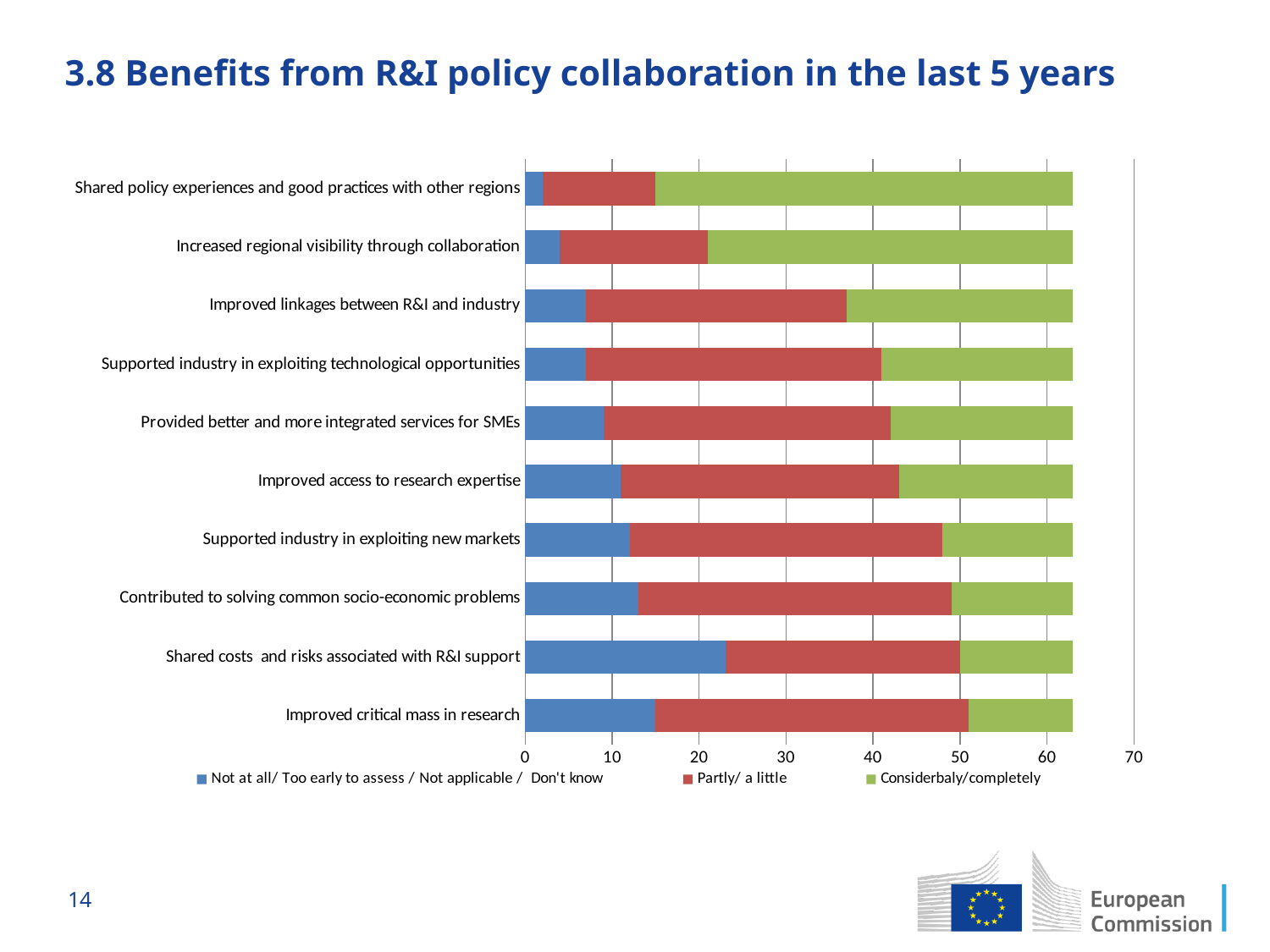
How many series does the legend list? 3 Which category has the smallest 'Not at all/ Too early to assess / Not applicable / Don't know' segment? Shared policy experiences and good practices with other regions What kind of chart is shown on the slide? Stacked bar chart Which has the larger 'Not at all/ Too early to assess / Not applicable / Don't know' segment: 'Shared costs and risks associated with R&I support' or 'Improved critical mass in research'? Shared costs and risks associated with R&I support What is the title of the slide's chart? 3.8 Benefits from R&I policy collaboration in the last 5 years Which colour represents the 'Partly/ a little' series? Red How many categories (benefits) are plotted on the chart? 10 Which category has the smallest 'Considerbaly/completely' segment? Improved critical mass in research Is the 'Not at all/ Too early to assess / Not applicable / Don't know' value for 'Shared costs and risks associated with R&I support' greater or less than 20? greater Is the 'Not at all/ Too early to assess / Not applicable / Don't know' value for 'Improved critical mass in research' greater or less than 10? greater Which category has the largest 'Not at all/ Too early to assess / Not applicable / Don't know' segment? Shared costs and risks associated with R&I support Which category has the largest 'Considerbaly/completely' segment? Shared policy experiences and good practices with other regions